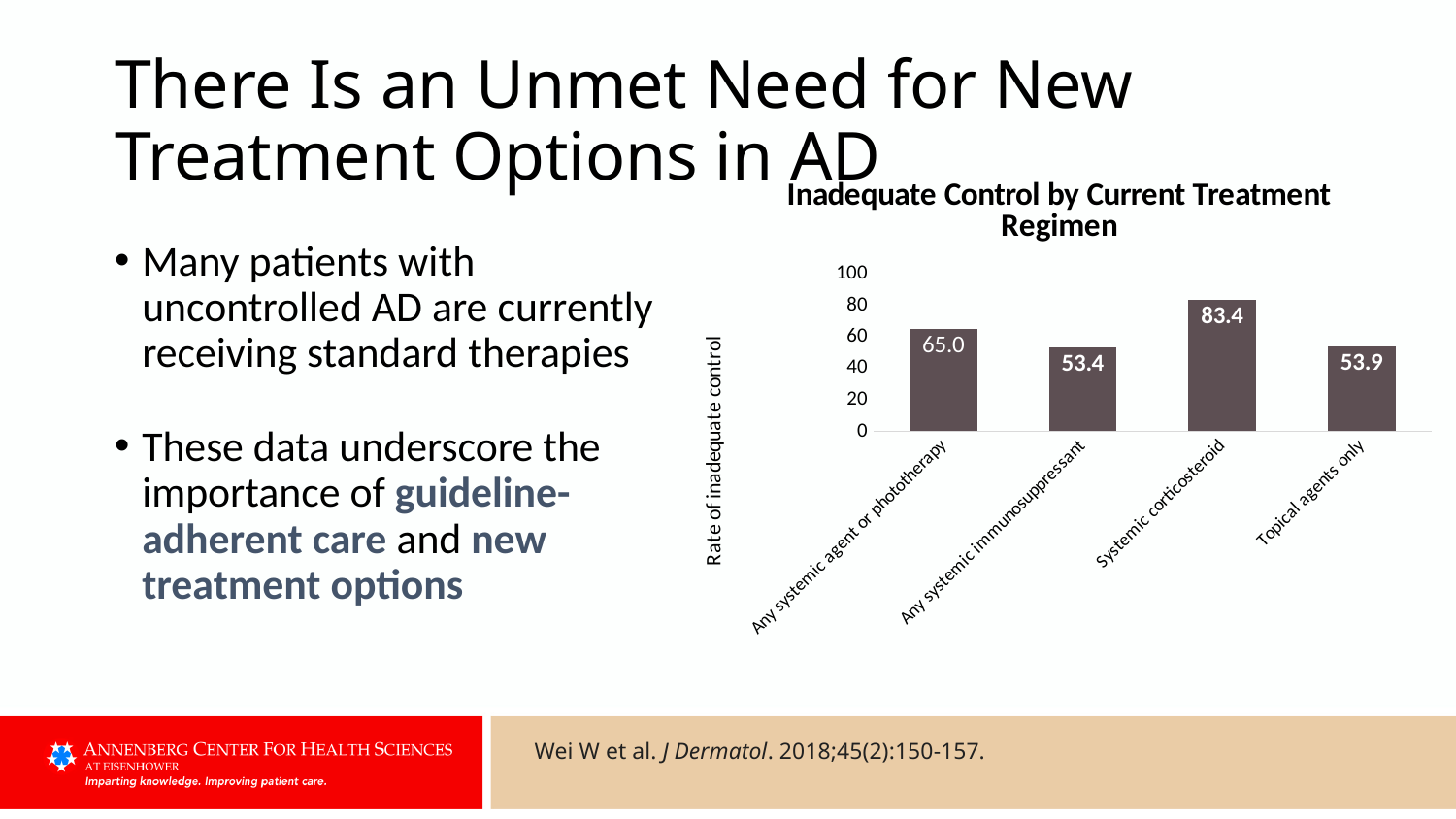
Which treatment regimen has the highest rate of inadequate control? Systemic corticosteroid What is the rate of inadequate control for Systemic corticosteroid? 83.4 What kind of chart is shown on the slide? Bar chart Which has a higher rate of inadequate control, Any systemic agent or phototherapy or Topical agents only? Any systemic agent or phototherapy What is the rate of inadequate control for Any systemic agent or phototherapy? 65.0 What is the rate of inadequate control for Topical agents only? 53.9 What is the title of the chart? Inadequate Control by Current Treatment Regimen What is the difference between the rate of inadequate control for Systemic corticosteroid and for Any systemic agent or phototherapy? 18.4 What is the rate of inadequate control for Any systemic immunosuppressant? 53.4 How many treatment regimens are shown in the chart? 4 What is the difference between the rate of inadequate control for Systemic corticosteroid and for Any systemic immunosuppressant? 30.0 Is the value for Topical agents only greater or less than 60? less